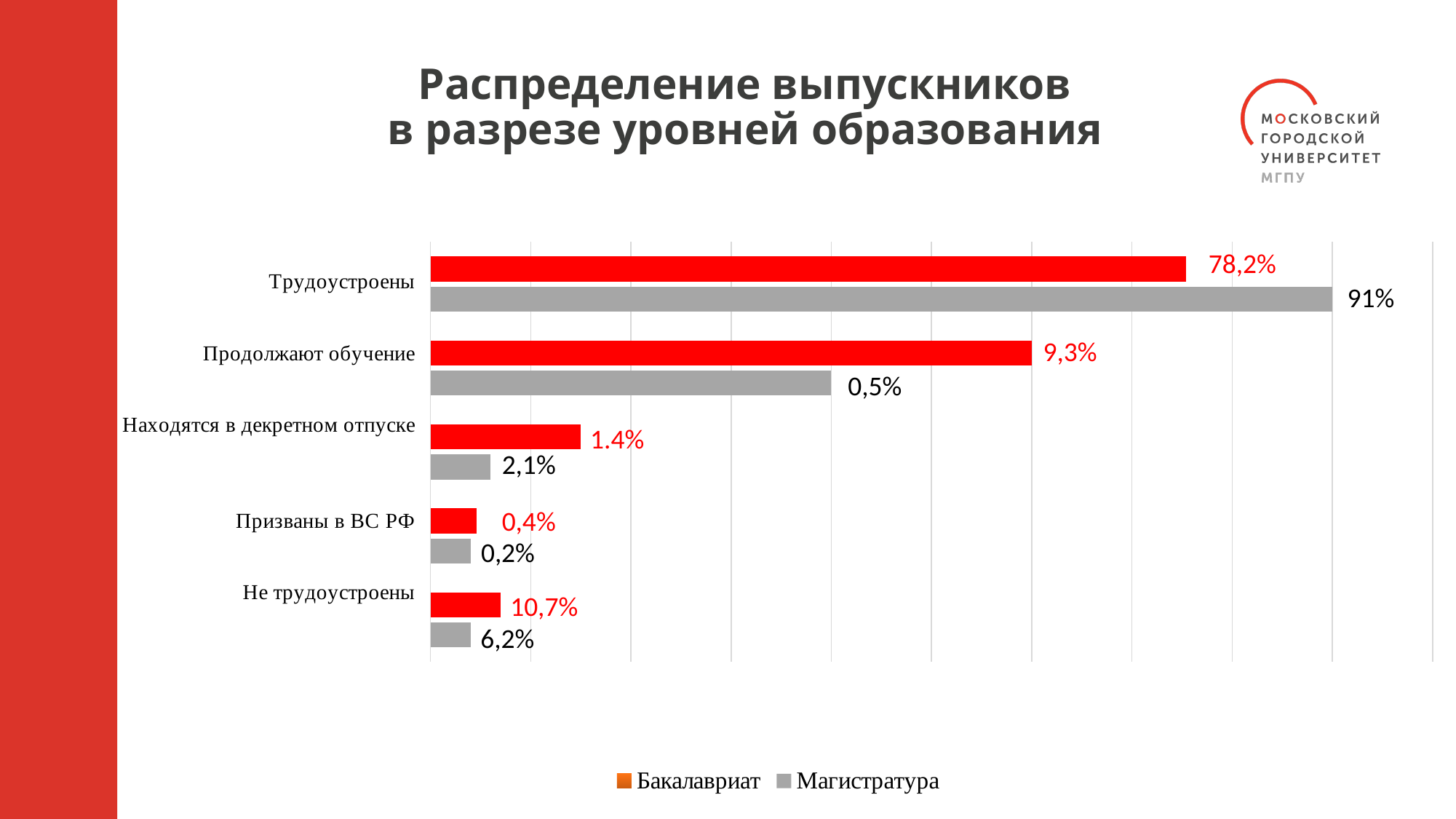
What is the Бакалавриат value for Не трудоустроены? 10,7% For Не трудоустроены, which series has the larger value, Бакалавриат or Магистратура? Бакалавриат What is the difference between the Бакалавриат and Магистратура values for Не трудоустроены? 4,5% Which category has the highest Бакалавриат value? Трудоустроены What is the Бакалавриат value for Трудоустроены? 78,2% What is the Магистратура value for Находятся в декретном отпуске? 2,1% How many categories are shown on the chart? 5 What is the difference between the Магистратура and Бакалавриат values for Трудоустроены? 12,8% What is the Магистратура value for Трудоустроены? 91% How many series does the legend list? 2 Which category has the lowest Бакалавриат value? Призваны в ВС РФ What is the Бакалавриат value for Призваны в ВС РФ? 0,4%